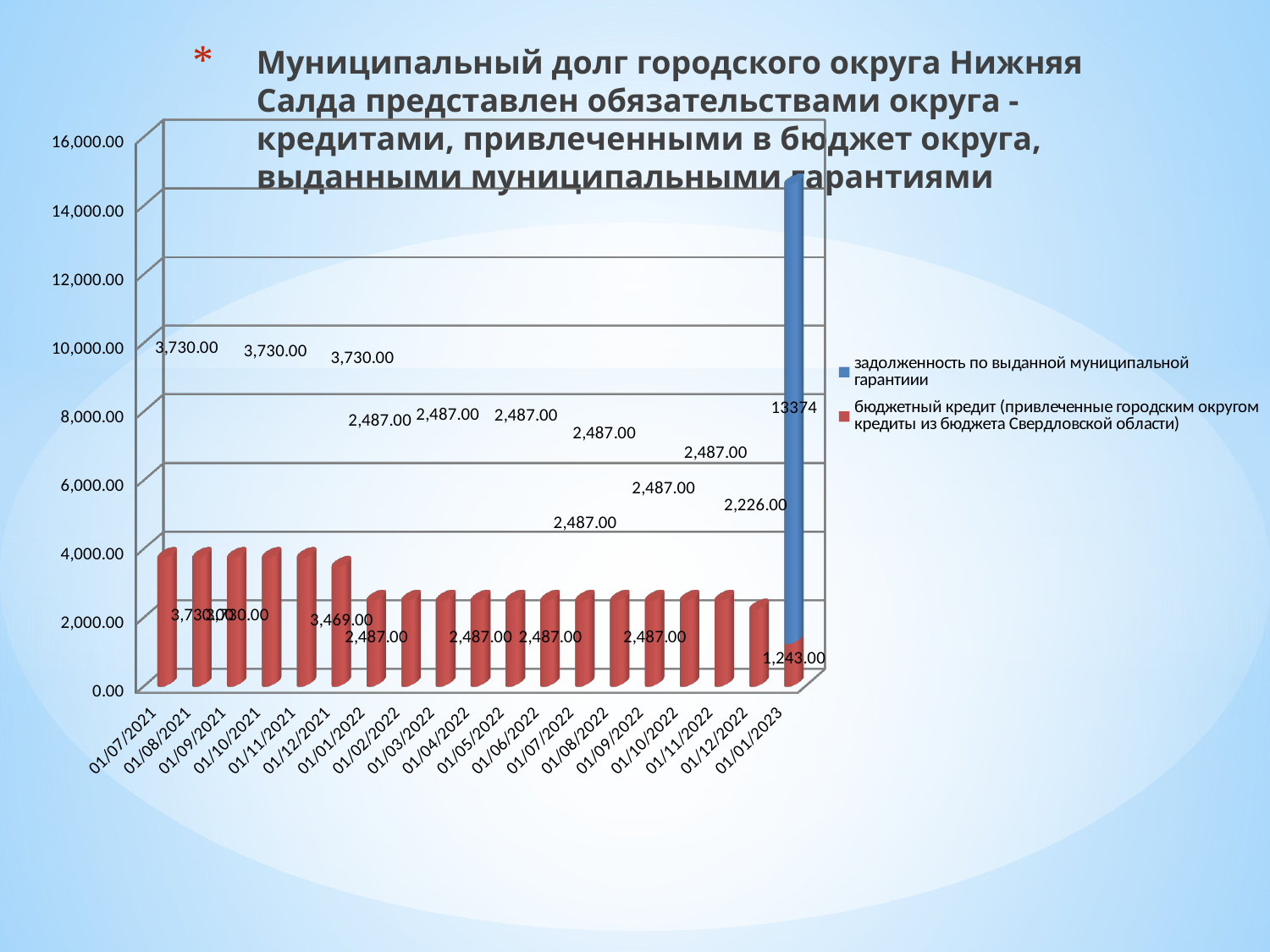
Which date has the tallest bar overall? 01/01/2023 How many dates are shown on the x axis? 19 How many series does the legend list? 2 What is the value of the red series (бюджетный кредит) for 01/07/2021? 3,730.00 What is the value of the red series (бюджетный кредит) for 01/12/2021? 3,469.00 What is the difference between the red series value for 01/07/2021 (3,730.00) and for 01/01/2022 (2,487.00)? 1,243.00 What is the value of the blue series (задолженность по выданной муниципальной гарантиии) for 01/01/2023? 13374 Which is larger for the red series: the value for 01/07/2021 or the value for 01/01/2022? 01/07/2021 What is the value of the red series (бюджетный кредит) for 01/01/2023? 1,243.00 What type of chart is shown on the slide? bar chart Which date has the lowest value for the red series (бюджетный кредит)? 01/01/2023 Is the blue bar for 01/01/2023 greater or less than 12,000.00? greater